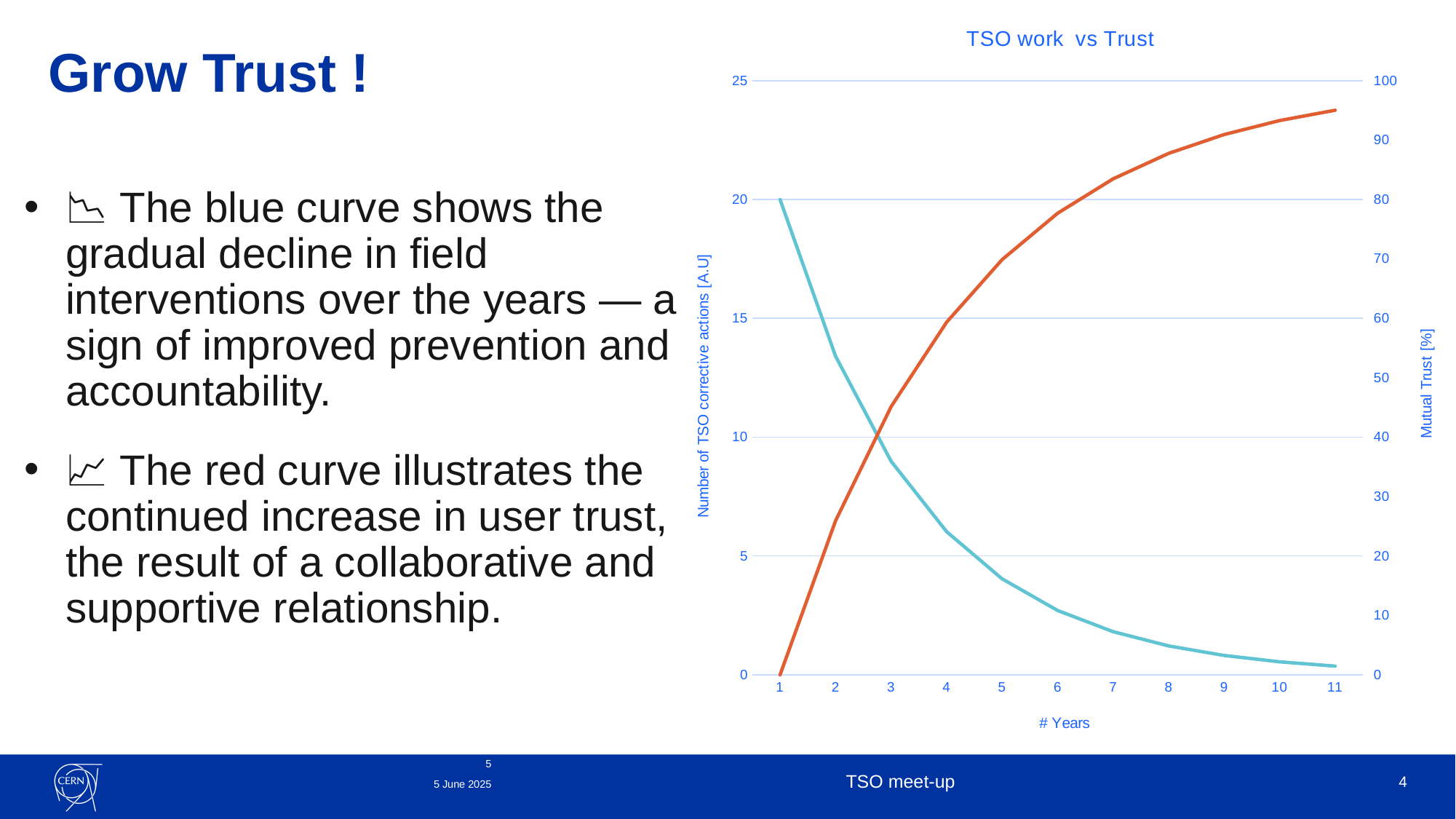
At which year is the blue curve (Number of TSO corrective actions) highest? 1 Is the value of the red curve (Mutual Trust) at year 11 greater or less than 90? greater What is the value of the red curve (Mutual Trust) at year 1? 0 What kind of chart is shown on the slide? line chart Is the value of the blue curve (Number of TSO corrective actions) at year 6 greater or less than 5? less What is the label of the x axis of the chart? # Years What is the value of the blue curve (Number of TSO corrective actions) at year 1? 20 What is the title of the chart? TSO work vs Trust Does the red curve (Mutual Trust) rise or fall as the years increase? rise How many years are plotted along the x axis of the chart? 11 At which year is the red curve (Mutual Trust) highest? 11 Does the blue curve (Number of TSO corrective actions) rise or fall as the years increase? fall